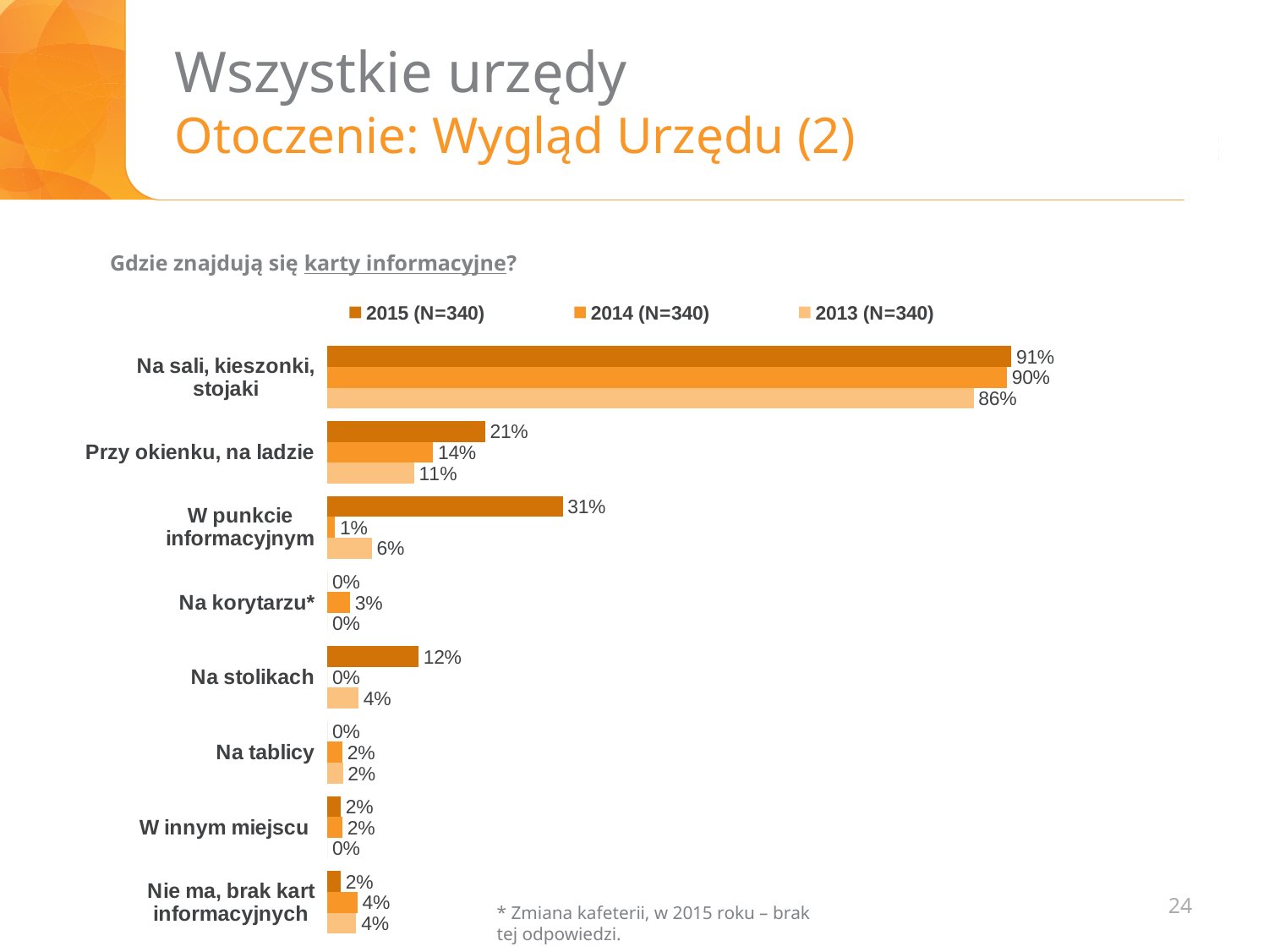
What is the difference between the 2015 and 2014 values for "Przy okienku, na ladzie"? 7% How many categories are shown on the chart? 8 What sample size (N) is given for the 2015 series in the legend? N=340 How many series does the legend list? 3 What is the 2015 value for "Na sali, kieszonki, stojaki"? 91% What kind of chart is shown on the slide? bar chart What is the 2014 value for "W punkcie informacyjnym"? 1% What is the 2014 value for "Na korytarzu*"? 3% What is the difference between the 2015 and 2013 values for "W punkcie informacyjnym"? 25% Which is larger for "Na stolikach": the 2015 value or the 2013 value? 2015 Which category has the highest 2015 value? Na sali, kieszonki, stojaki What is the 2013 value for "Przy okienku, na ladzie"? 11%